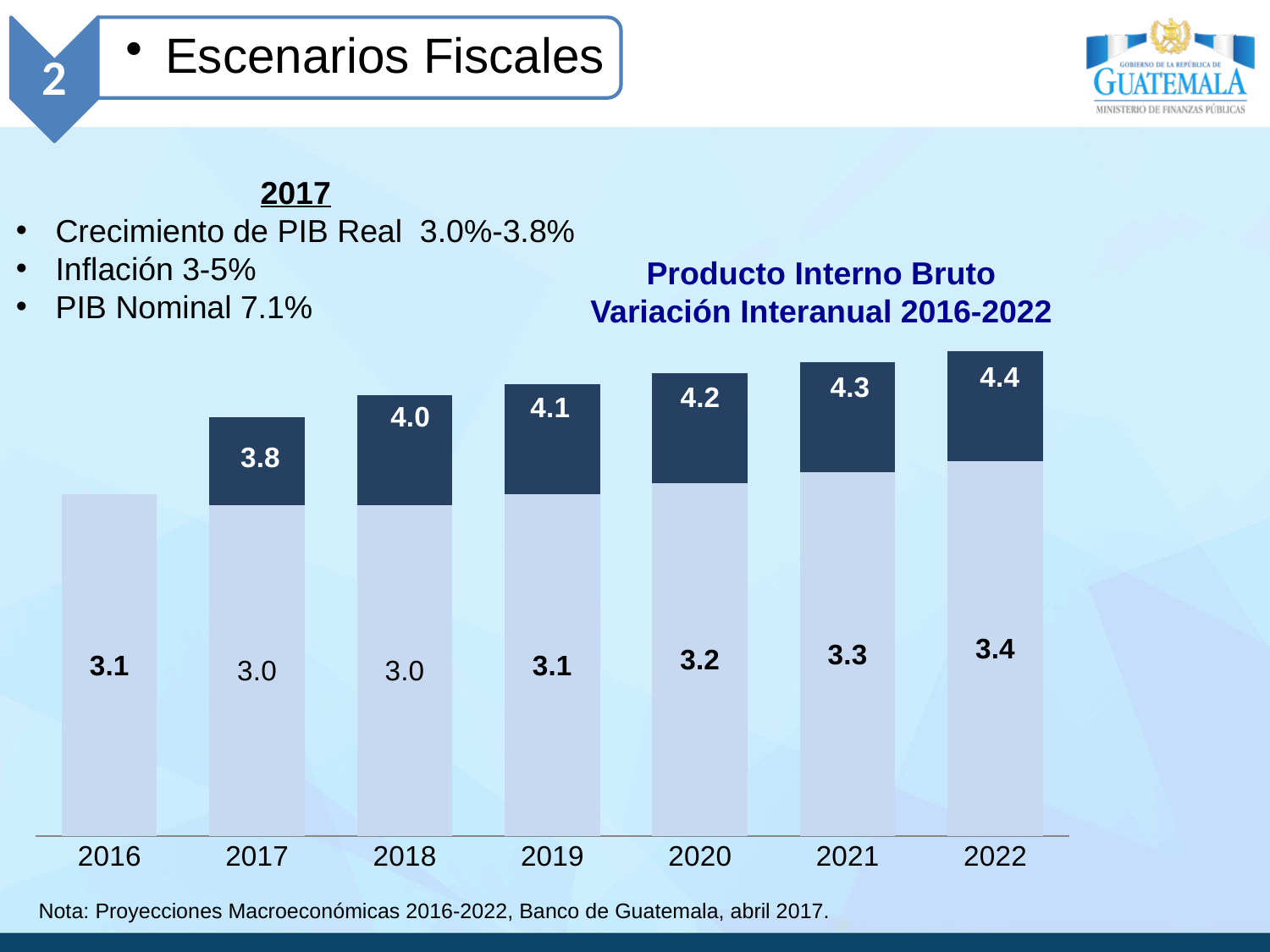
What is the value shown in the dark blue segment of the bar for 2022? 4.4 What is the difference between the dark blue value for 2022 and the dark blue value for 2017? 0.6 Is the light blue value for 2021 larger or smaller than the light blue value for 2018? larger What type of chart is shown on the slide? bar chart What is the value shown in the light blue segment of the bar for 2016? 3.1 Which year has the highest value in the dark blue segment? 2022 Do the dark blue values rise or fall from 2017 to 2022? rise What is the value shown in the light blue segment of the bar for 2020? 3.2 Which years have the lowest value in the light blue segment? 2017 and 2018 How many years are shown on the x axis of the chart? 7 What is the value shown in the dark blue segment of the bar for 2017? 3.8 What is the title of the chart? Producto Interno Bruto Variación Interanual 2016-2022